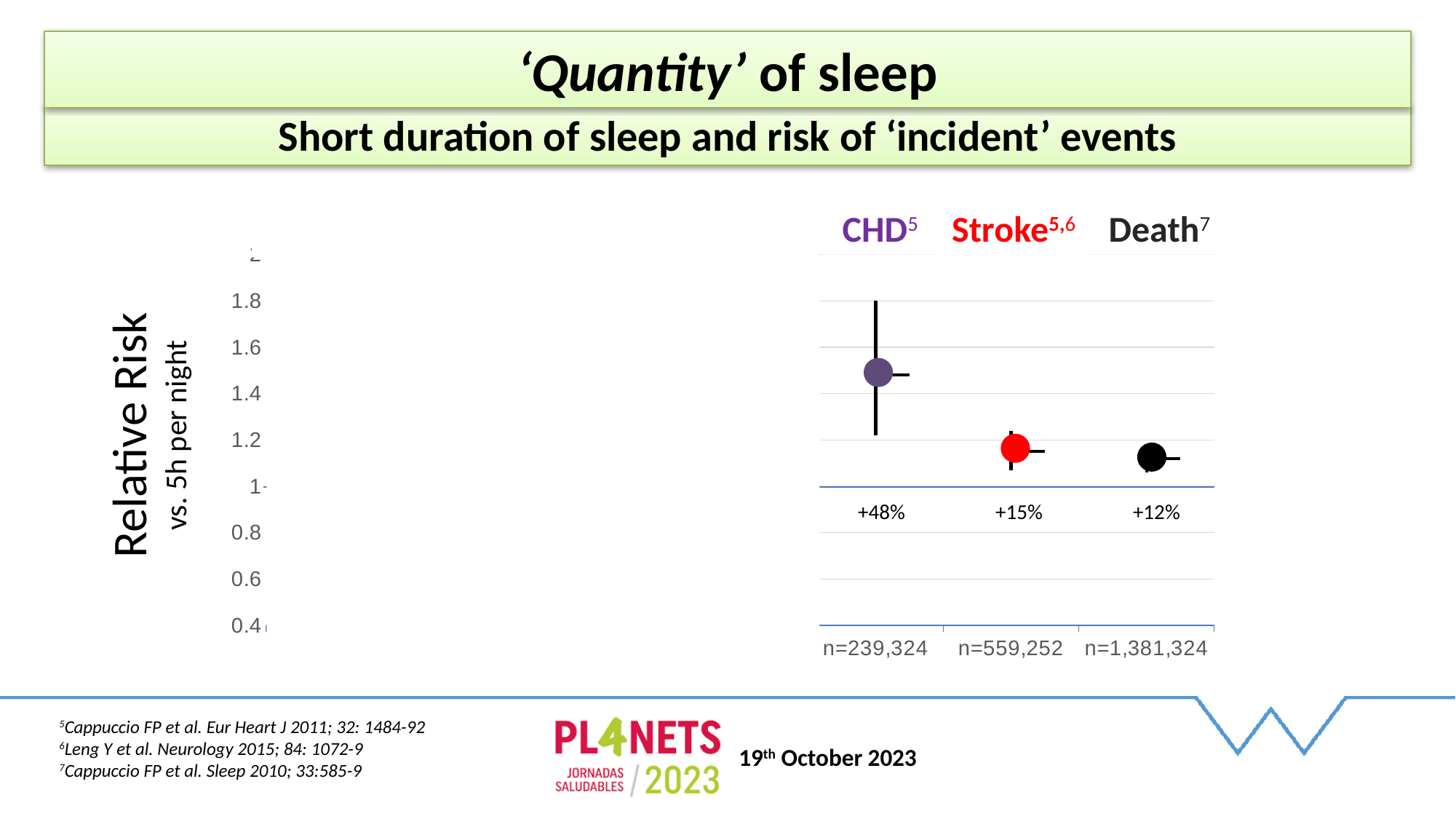
What is the label of the vertical axis? Relative Risk vs. 5h per night What is the sample size (n) shown for the Death outcome? n=1,381,324 What is the percentage increase in risk shown for Death? +12% Is the relative risk for CHD greater or less than 1.4? greater How many outcomes are plotted on the chart? 3 What is the percentage increase in risk shown for CHD? +48% What is the sample size (n) shown for the CHD outcome? n=239,324 Which outcome has the highest relative risk? CHD Which has a larger relative risk, CHD or Stroke? CHD Which outcome has the lowest percentage increase in risk? Death What is the percentage increase in risk shown for Stroke? +15%